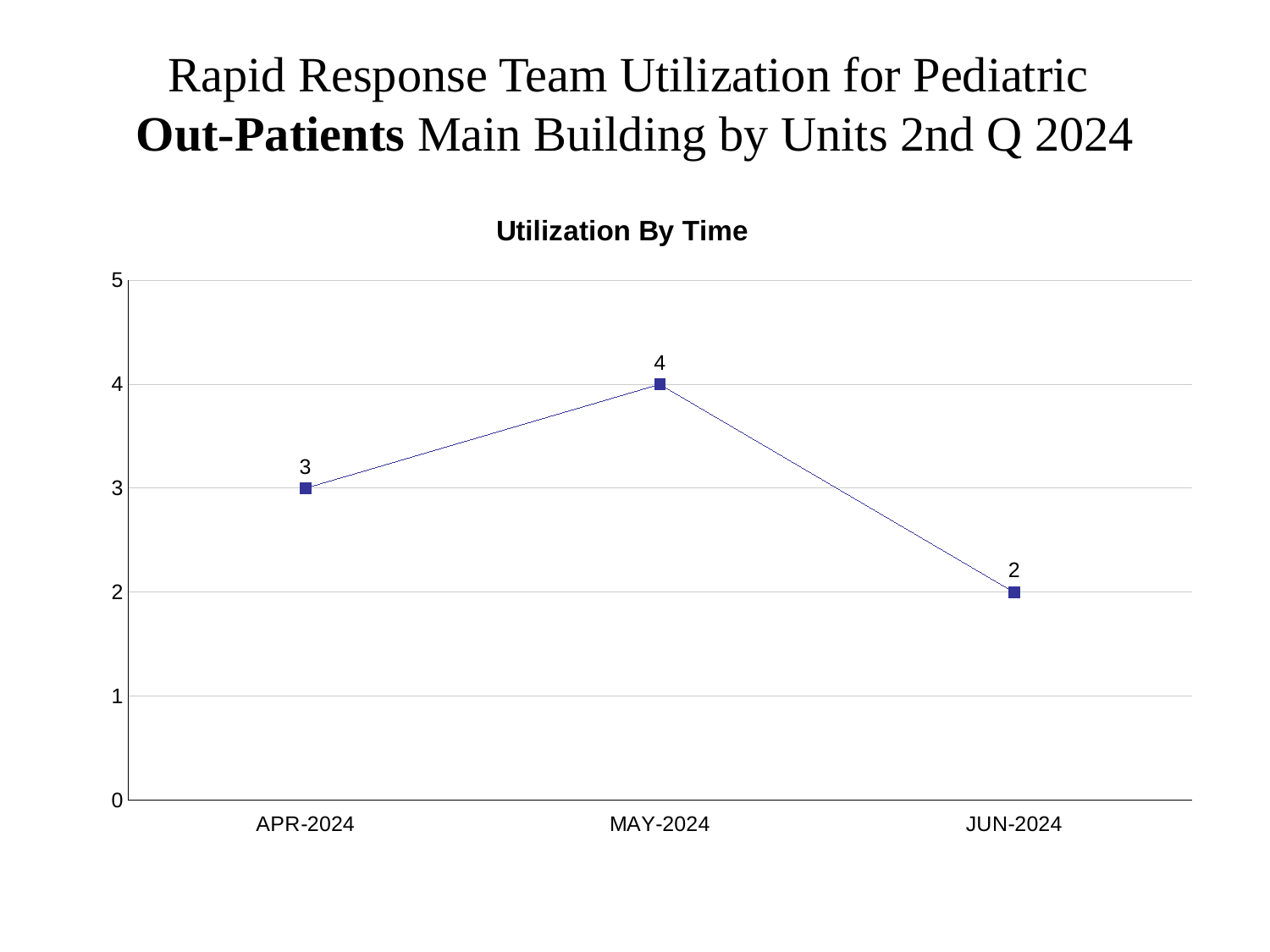
Does the value rise or fall from MAY-2024 to JUN-2024? Fall Which is larger, the value for APR-2024 or the value for JUN-2024? APR-2024 What kind of chart is shown on the slide? Line chart How many data points are plotted on the chart? 3 What is the value for JUN-2024? 2 What is the difference between the values for APR-2024 and MAY-2024? 1 What is the value for MAY-2024? 4 Which month has the highest value? MAY-2024 What is the difference between the values for MAY-2024 and JUN-2024? 2 What is the value for APR-2024? 3 What is the title of the chart? Utilization By Time Which month has the lowest value? JUN-2024